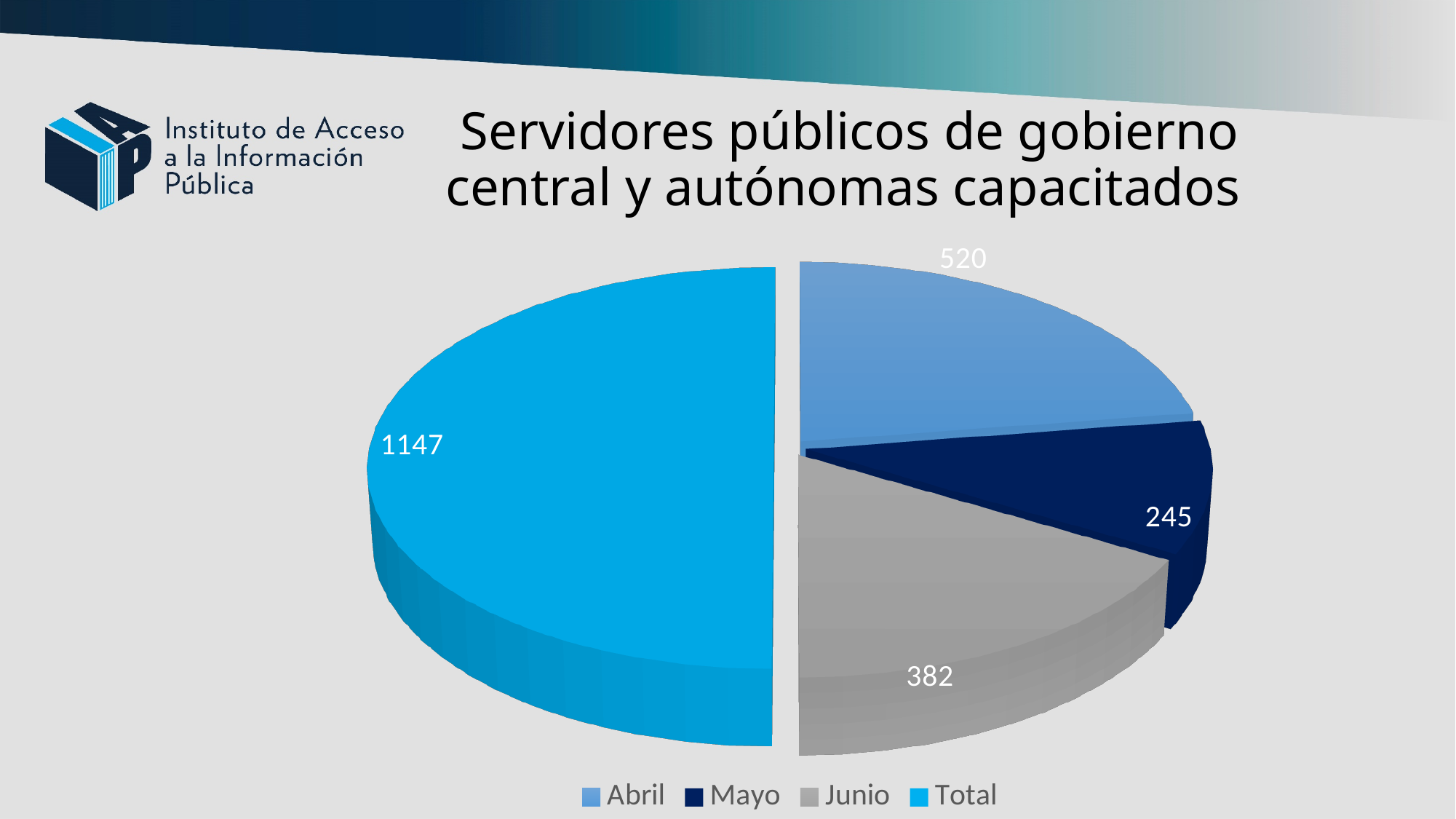
What is the difference between the values for Abril and Mayo? 275 What is the value for Junio? 382 What is the value for Total? 1147 Which slice has the largest value? Total What is the value for Abril? 520 What share of the pie does the Total slice represent? 50% Which is larger, the value for Junio or the value for Mayo? Junio What type of chart is shown on the slide? pie chart What is the value for Mayo? 245 What is the title of the chart? Servidores públicos de gobierno central y autónomas capacitados Which slice has the smallest value? Mayo How many slices does the pie chart have? 4